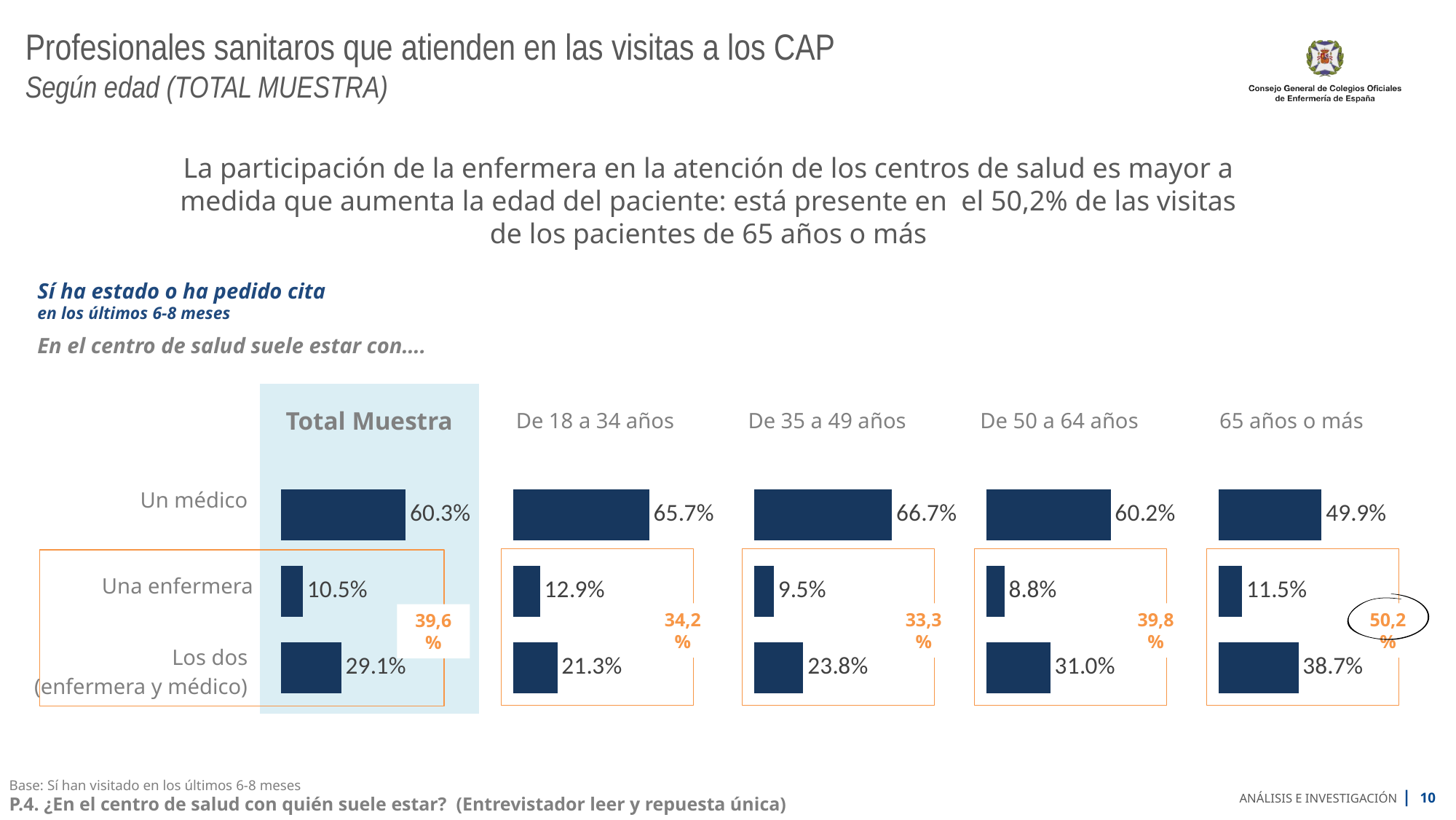
In the 'De 18 a 34 años' chart, which category has the lowest value? Una enfermera In the 'Total Muestra' chart, what is the difference between 'Un médico' and 'Los dos (enfermera y médico)'? 31.2 percentage points In the '65 años o más' chart, what is the difference between 'Un médico' and 'Los dos (enfermera y médico)'? 11.2 percentage points In the 'De 35 a 49 años' chart, which category has the highest value? Un médico How many categories does each chart on the slide show? 3 What orange value is shown next to the '65 años o más' chart? 50,2% Across the age-group charts from 'De 18 a 34 años' to '65 años o más', does the value for 'Los dos (enfermera y médico)' rise or fall? Rise In the '65 años o más' chart, what is the value for 'Los dos (enfermera y médico)'? 38.7% In the 'Total Muestra' chart, what is the value for 'Un médico'? 60.3% In the 'De 50 a 64 años' chart, what is the value for 'Una enfermera'? 8.8% What kind of chart is used for the 'Total Muestra' data? Bar chart Which is larger: 'Una enfermera' in the 'De 18 a 34 años' chart or 'Una enfermera' in the 'De 35 a 49 años' chart? De 18 a 34 años